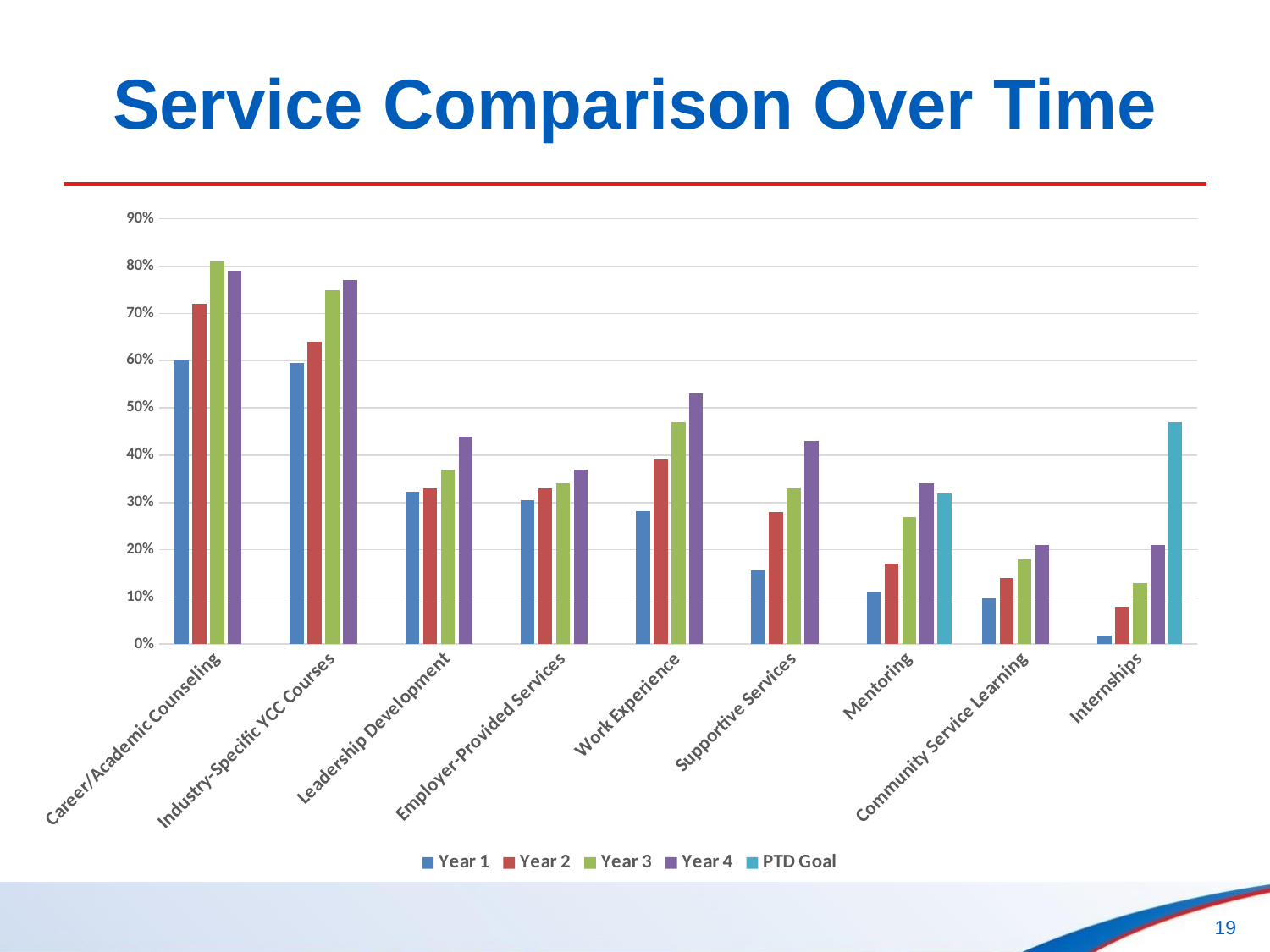
How many series does the legend list? 5 Is the Year 1 value for Career/Academic Counseling greater or less than 50%? greater Which series has the highest value for Internships? PTD Goal Is the Year 4 value for Leadership Development greater or less than 40%? greater Is the PTD Goal value for Internships greater or less than 40%? greater What is the title of the slide? Service Comparison Over Time How many service categories are shown on the x axis? 9 Which is larger, the Year 4 value for Work Experience or the Year 4 value for Supportive Services? Work Experience What kind of chart is shown on the slide? Bar chart Which category has the lowest Year 1 value? Internships For Mentoring, do the values rise or fall from Year 1 to Year 4? rise